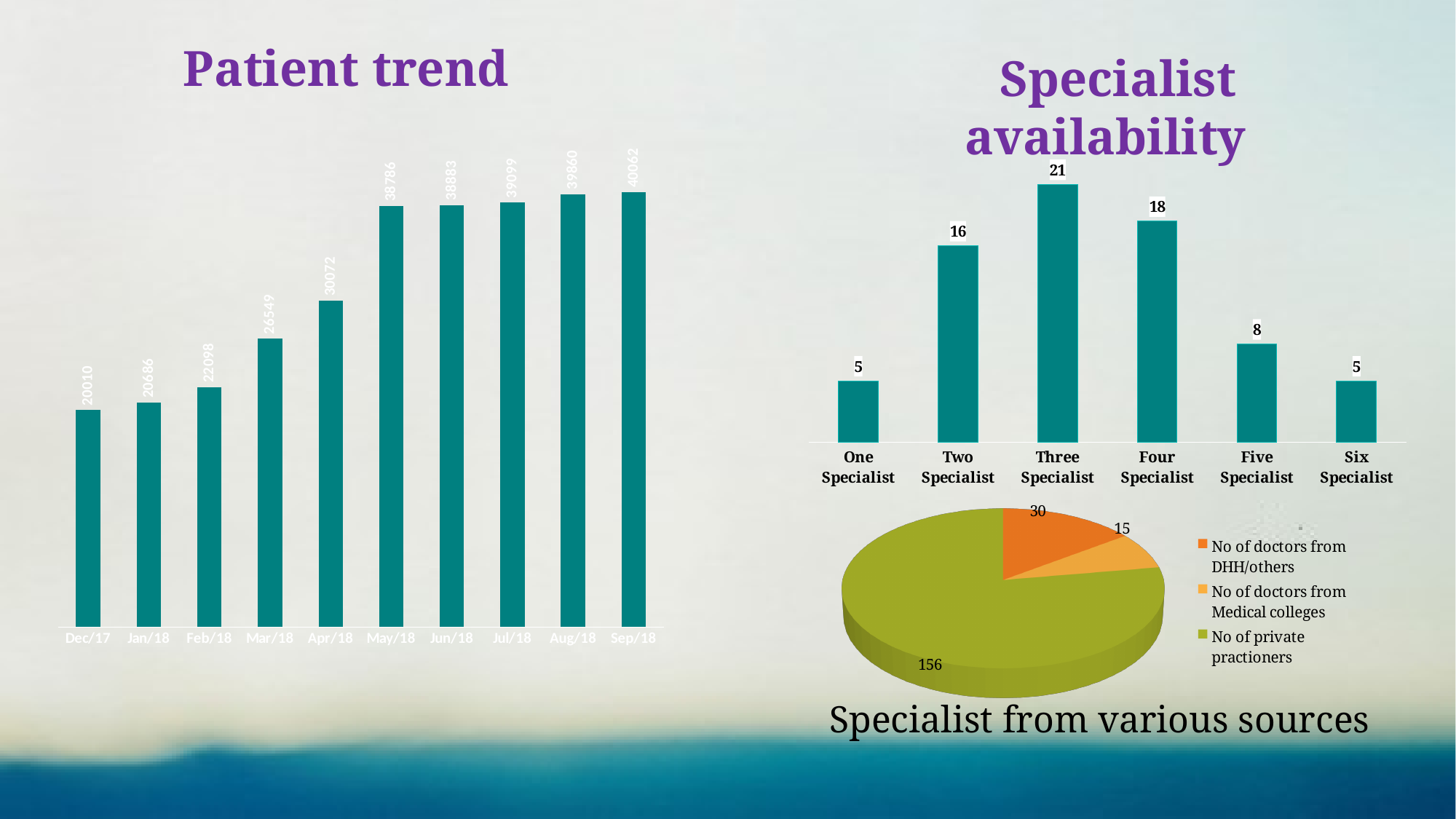
In the Patient trend chart, do the values generally rise or fall from Dec/17 to Sep/18? rise In the Specialist availability chart, which category has the highest value? Three Specialist In the Specialist availability chart, what is the value for Four Specialist? 18 In the Patient trend chart, what is the difference between the values for May/18 and Apr/18? 8714 In the Patient trend chart, what is the value for Mar/18? 26549 How many months are shown in the Patient trend chart? 10 In the Patient trend chart, what is the value for Sep/18? 40062 In the Specialist from various sources pie chart, what is the value for No of private practioners? 156 What kind of chart is the Specialist from various sources chart? pie chart In the Specialist from various sources pie chart, which is larger: No of doctors from DHH/others or No of doctors from Medical colleges? No of doctors from DHH/others In the Specialist availability chart, what is the difference between Two Specialist and Five Specialist? 8 In the Patient trend chart, which month has the lowest value? Dec/17